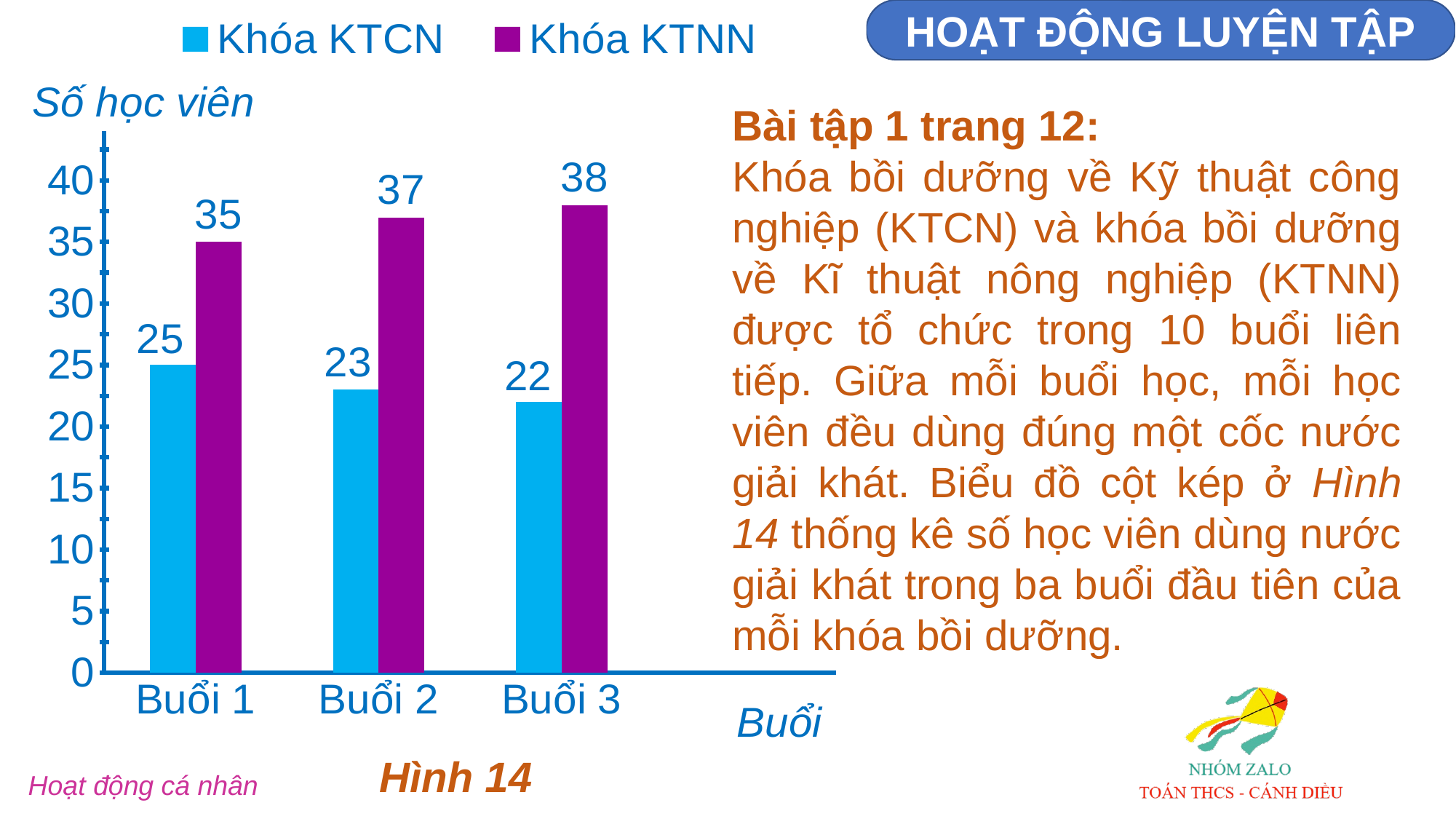
How many series does the legend list? 2 How many sessions (Buổi) are shown on the x axis? 3 What kind of chart is shown? Bar chart Do the values for Khóa KTCN rise or fall from Buổi 1 to Buổi 3? Fall What is the value for Khóa KTCN in Buổi 1? 25 Which session (Buổi) has the lowest value for Khóa KTCN? Buổi 3 What is the value for Khóa KTNN in Buổi 2? 37 What is the difference between Khóa KTNN and Khóa KTCN in Buổi 1? 10 What is the difference between Khóa KTNN in Buổi 3 and Khóa KTNN in Buổi 1? 3 What is the value for Khóa KTNN in Buổi 3? 38 Which session (Buổi) has the highest value for Khóa KTNN? Buổi 3 Which is larger in Buổi 2: Khóa KTCN or Khóa KTNN? Khóa KTNN